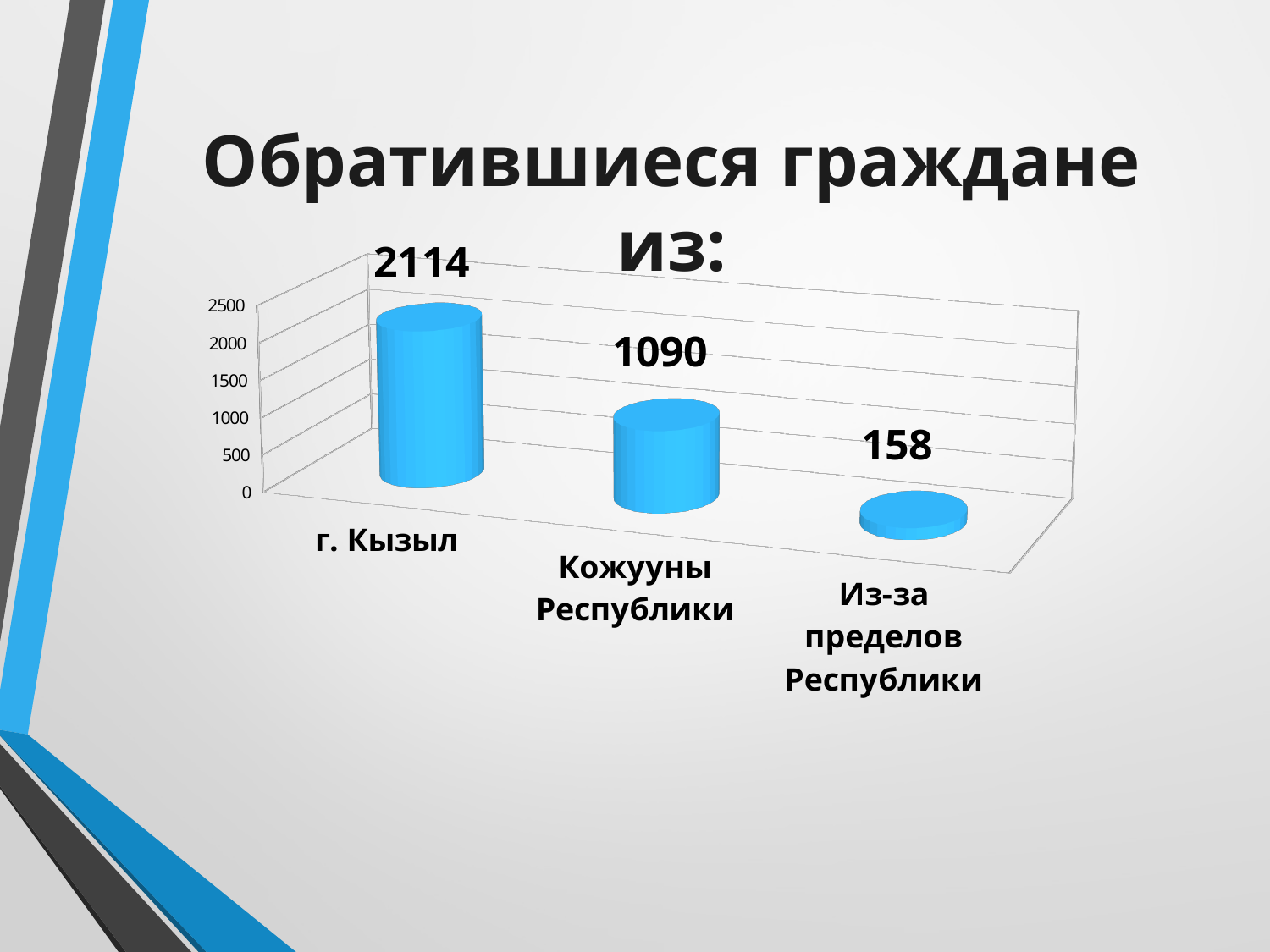
What is the difference between the values for Кожууны Республики and Из-за пределов Республики? 932 What is the value for Из-за пределов Республики? 158 What kind of chart is shown on the slide? bar chart What is the value for г. Кызыл? 2114 What is the value for Кожууны Республики? 1090 What is the difference between the values for г. Кызыл and Кожууны Республики? 1024 Which is larger, the value for Кожууны Республики or the value for Из-за пределов Республики? Кожууны Республики Which category has the lowest value? Из-за пределов Республики How many categories are shown in the chart? 3 Which category has the highest value? г. Кызыл What is the title of the slide? Обратившиеся граждане из: Is the value for г. Кызыл greater or less than 2000? greater